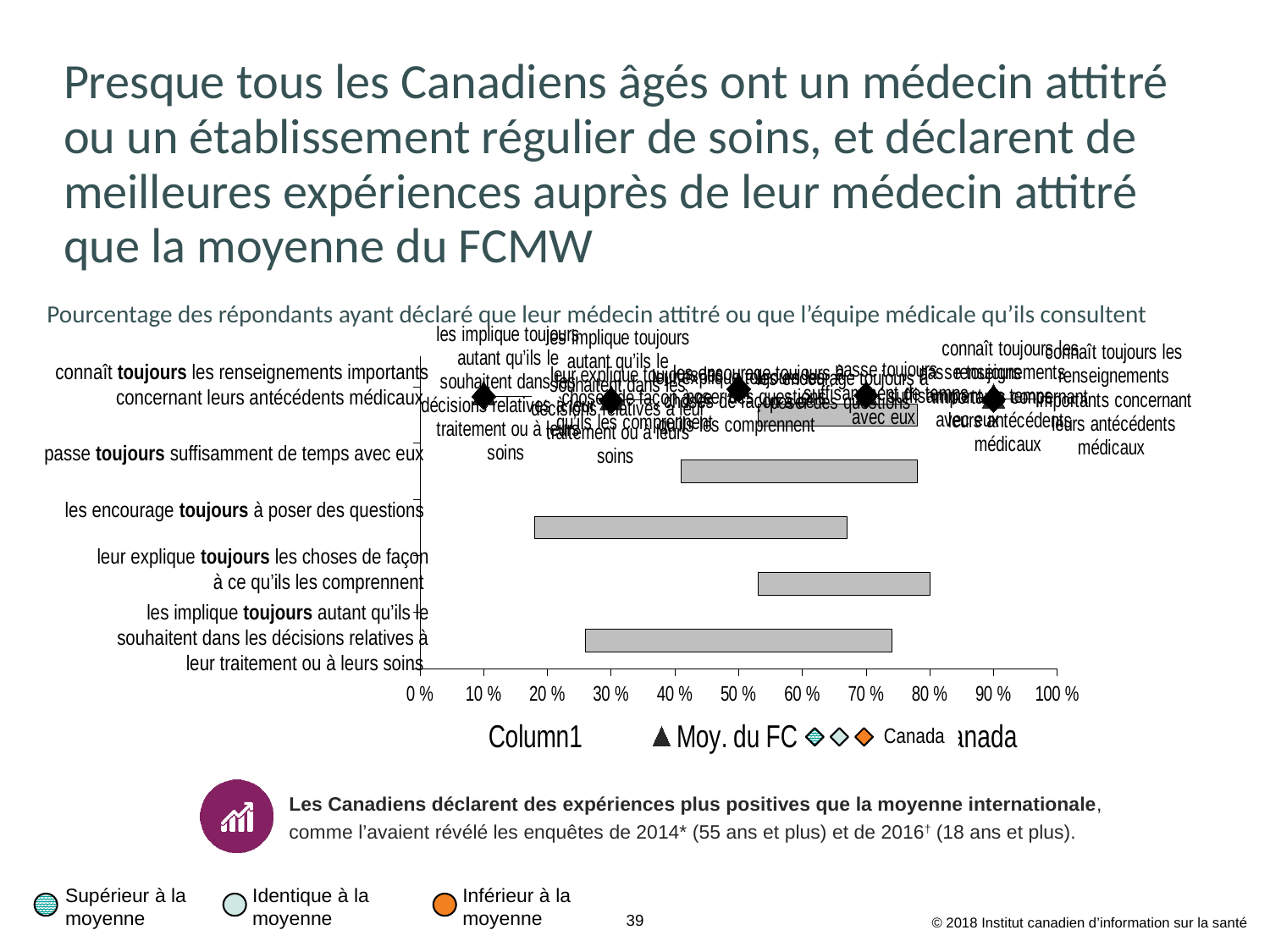
What is the interval between consecutive tick marks on the horizontal axis? 10 % What kind of chart is shown on the slide? bar chart Is the left end of the bar for 'connaît toujours les renseignements importants concernant leurs antécédents médicaux' greater or less than 40 %? greater Is the right end of the bar for 'les encourage toujours à poser des questions' greater or less than 60 %? greater What is the highest tick value shown on the horizontal axis of the chart? 100 % Is the right end of the bar for 'leur explique toujours les choses de façon à ce qu'ils les comprennent' greater or less than 70 %? greater Which category's bar extends furthest to the left on the chart? les encourage toujours à poser des questions How many categories are listed on the vertical axis of the chart? 5